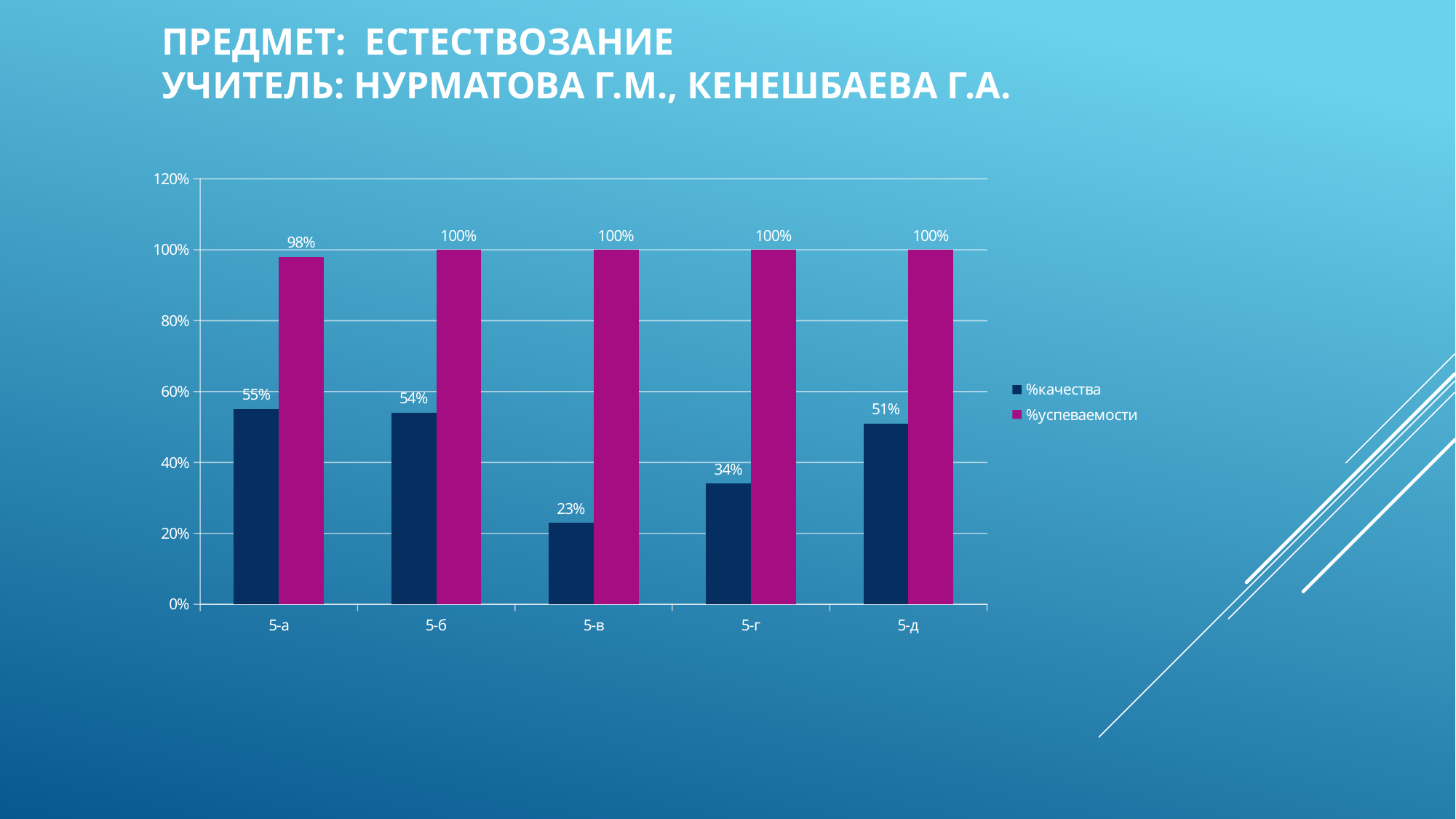
What is the difference between %успеваемости and %качества for class 5-г? 66% What is the %качества value for class 5-в? 23% What is the difference between the %качества values for 5-а and 5-в? 32% What kind of chart is shown on the slide? bar chart Which class has the highest %качества value? 5-а Which is larger, the %качества value for 5-г or for 5-д? 5-д What is the %успеваемости value for class 5-а? 98% How many series does the legend list? 2 What is the %качества value for class 5-д? 51% How many classes are shown on the x axis? 5 Which class has the lowest %качества value? 5-в Which class has the lowest %успеваемости value? 5-а